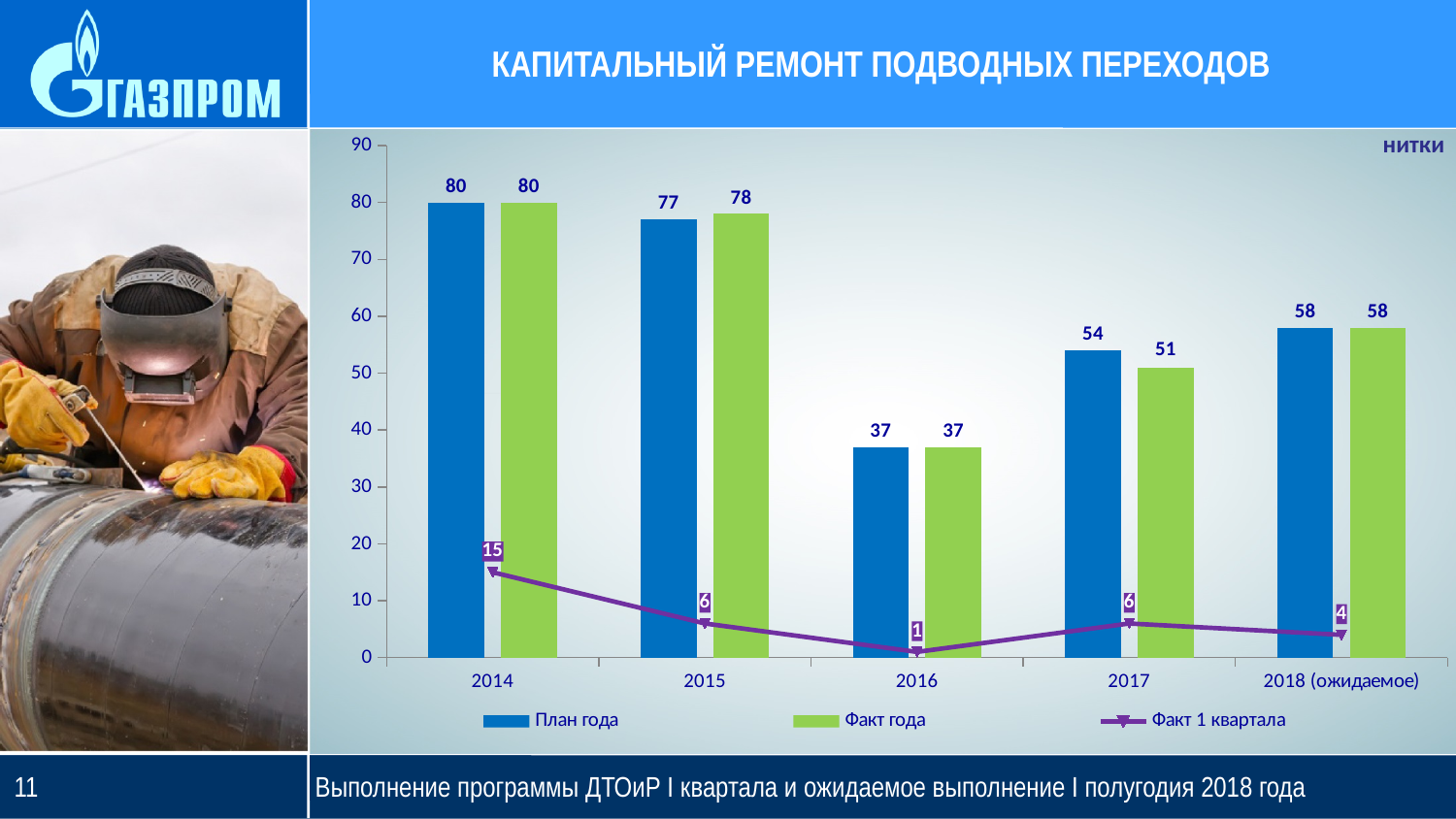
What is the difference between "План года" and "Факт года" for 2017? 3 What is the value of "План года" for 2015? 77 Does the "Факт 1 квартала" line rise or fall from 2014 to 2016? Fall What is the value of "Факт 1 квартала" for 2014? 15 What is the value of "Факт года" for 2017? 51 What is the title of the chart? КАПИТАЛЬНЫЙ РЕМОНТ ПОДВОДНЫХ ПЕРЕХОДОВ In which year is the "План года" value highest? 2014 What kind of chart is shown on the slide? Combined bar and line chart How many series does the legend list? 3 How many categories are shown on the x axis? 5 Which is larger for 2015: "План года" or "Факт года"? Факт года In which year is the "Факт года" value lowest? 2016